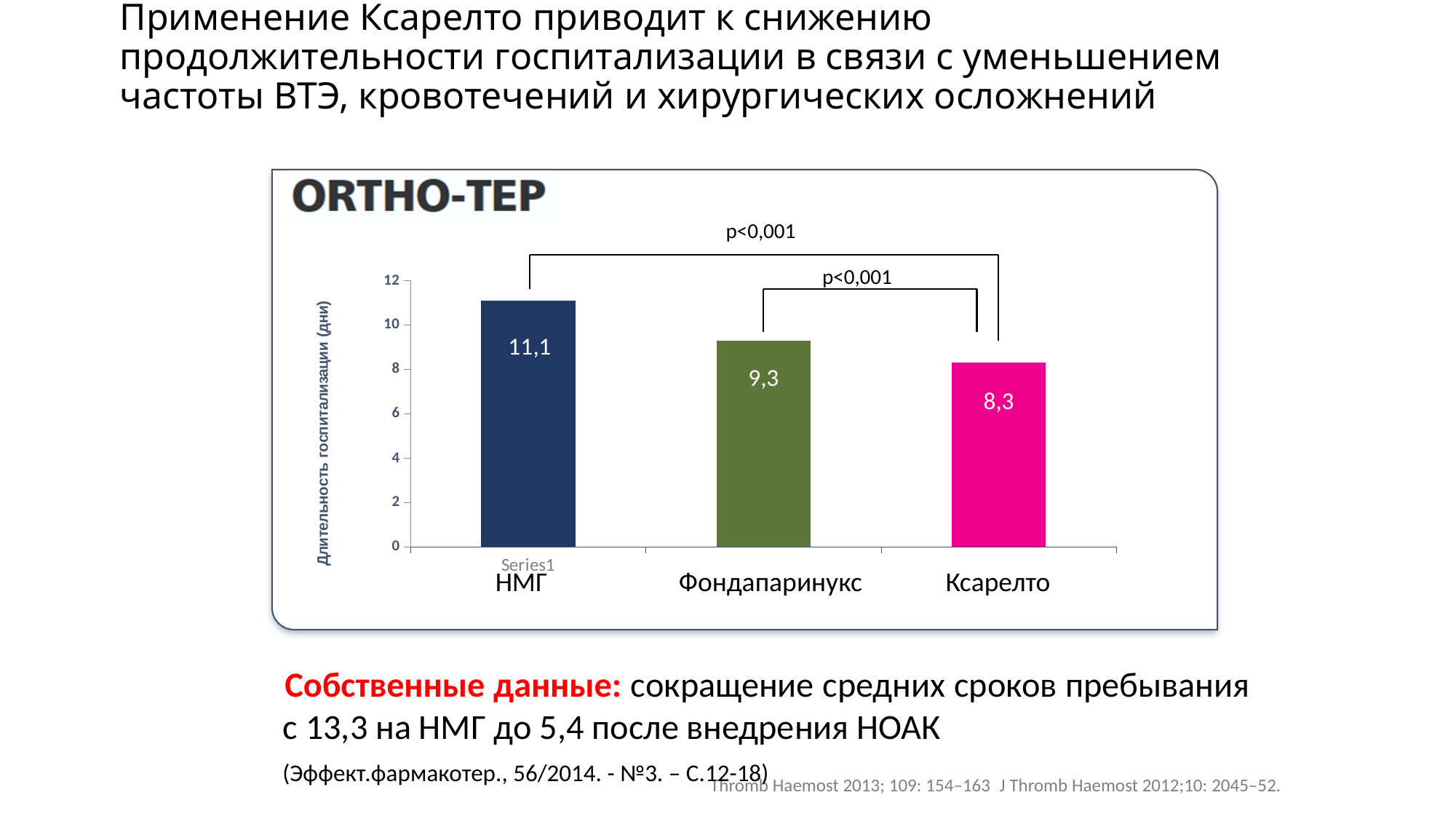
What is the difference between the values for Фондапаринукс and Ксарелто? 1,0 Which is larger, the value for Фондапаринукс or the value for Ксарелто? Фондапаринукс What kind of chart is shown on the slide? bar chart What is the value shown for Фондапаринукс? 9,3 Which category has the highest value? НМГ What is the hospitalization duration value shown for НМГ? 11,1 How many categories are shown on the x axis? 3 Is the value for НМГ greater or less than 10? greater Which category has the lowest value? Ксарелто What is the label of the vertical axis? Длительность госпитализации (дни) What is the difference between the values for НМГ and Ксарелто? 2,8 What is the value shown for Ксарелто? 8,3